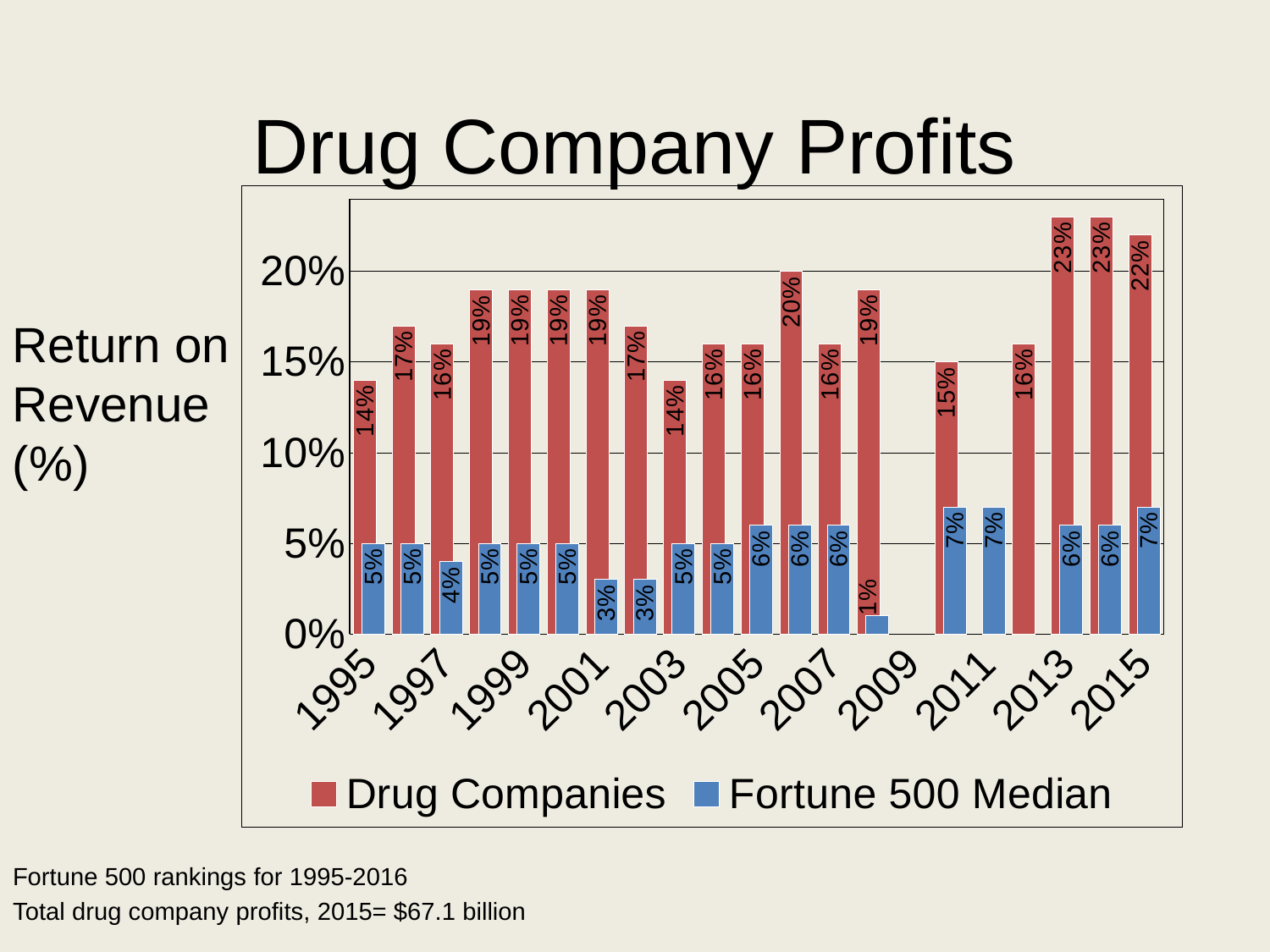
What is the Drug Companies value for 1995? 14% What are the two series named in the legend? Drug Companies and Fortune 500 Median What is the title of the chart? Drug Company Profits What is the highest value shown for the Drug Companies series? 23% What is the Drug Companies value for 2015? 22% How many series does the legend list? 2 What kind of chart is shown on the slide? Bar chart In 2015, how much higher is the Drug Companies value than the Fortune 500 Median value? 15 percentage points What is the lowest value shown for the Fortune 500 Median series? 1% What is the Fortune 500 Median value for 2015? 7% Which year has the larger Drug Companies value, 1995 or 2013? 2013 What is the Fortune 500 Median value for 2001? 3%